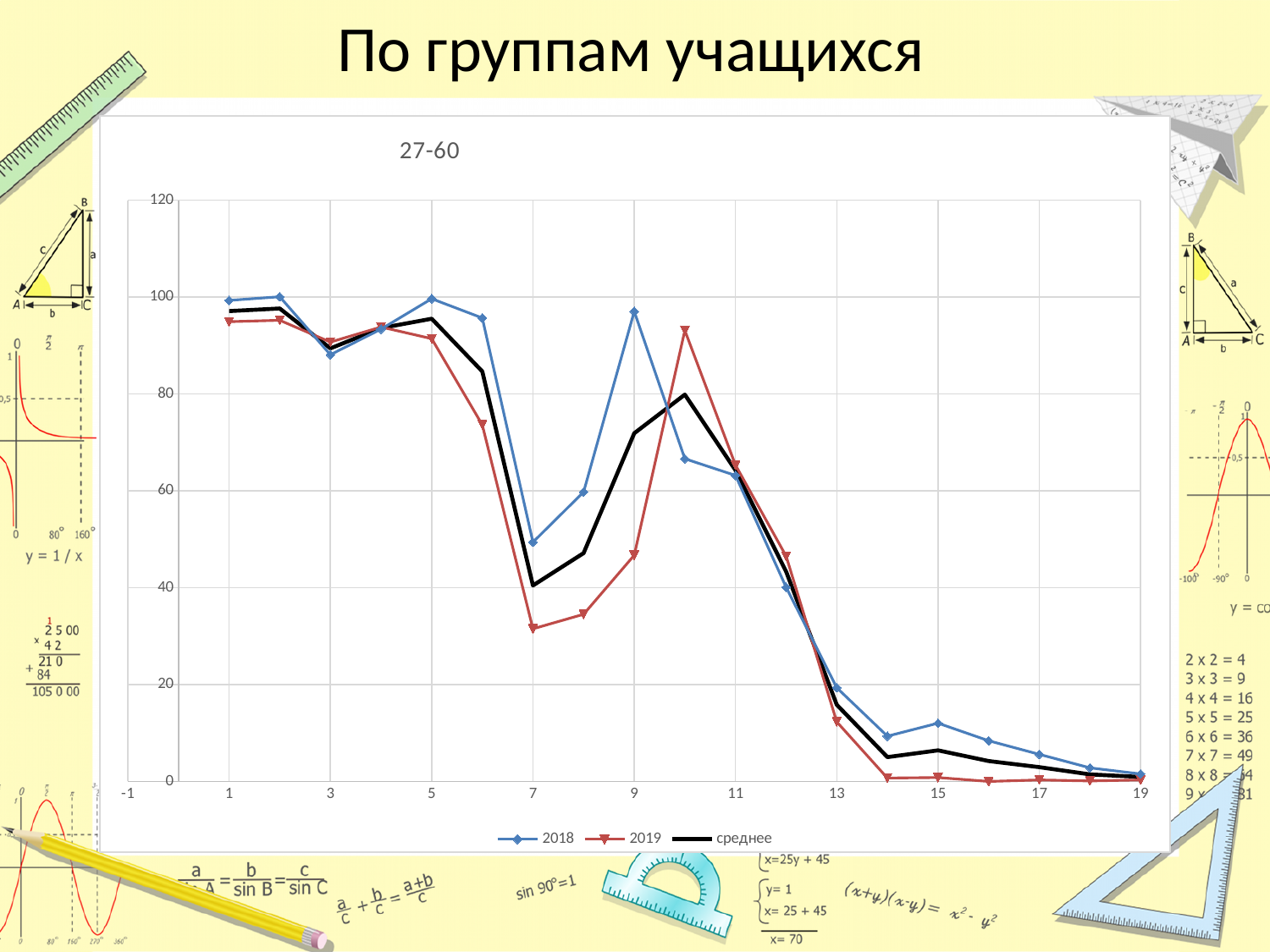
At x = 9, which series has the larger value, 2018 or 2019? 2018 Is the value for 2018 at x = 7 greater or less than 60? less How many series does the legend list? 3 Is the value for 2019 at x = 7 greater or less than 40? less What are the series names listed in the legend? 2018, 2019, среднее At x = 10, which series has the larger value, 2018 or 2019? 2019 What is the title of the chart? 27-60 How many data points does each series have along the x axis? 19 Overall, do the values of the среднее series rise or fall from x = 1 to x = 19? fall Is the value for 2019 at x = 10 greater or less than 80? greater What kind of chart is shown on the slide? line chart